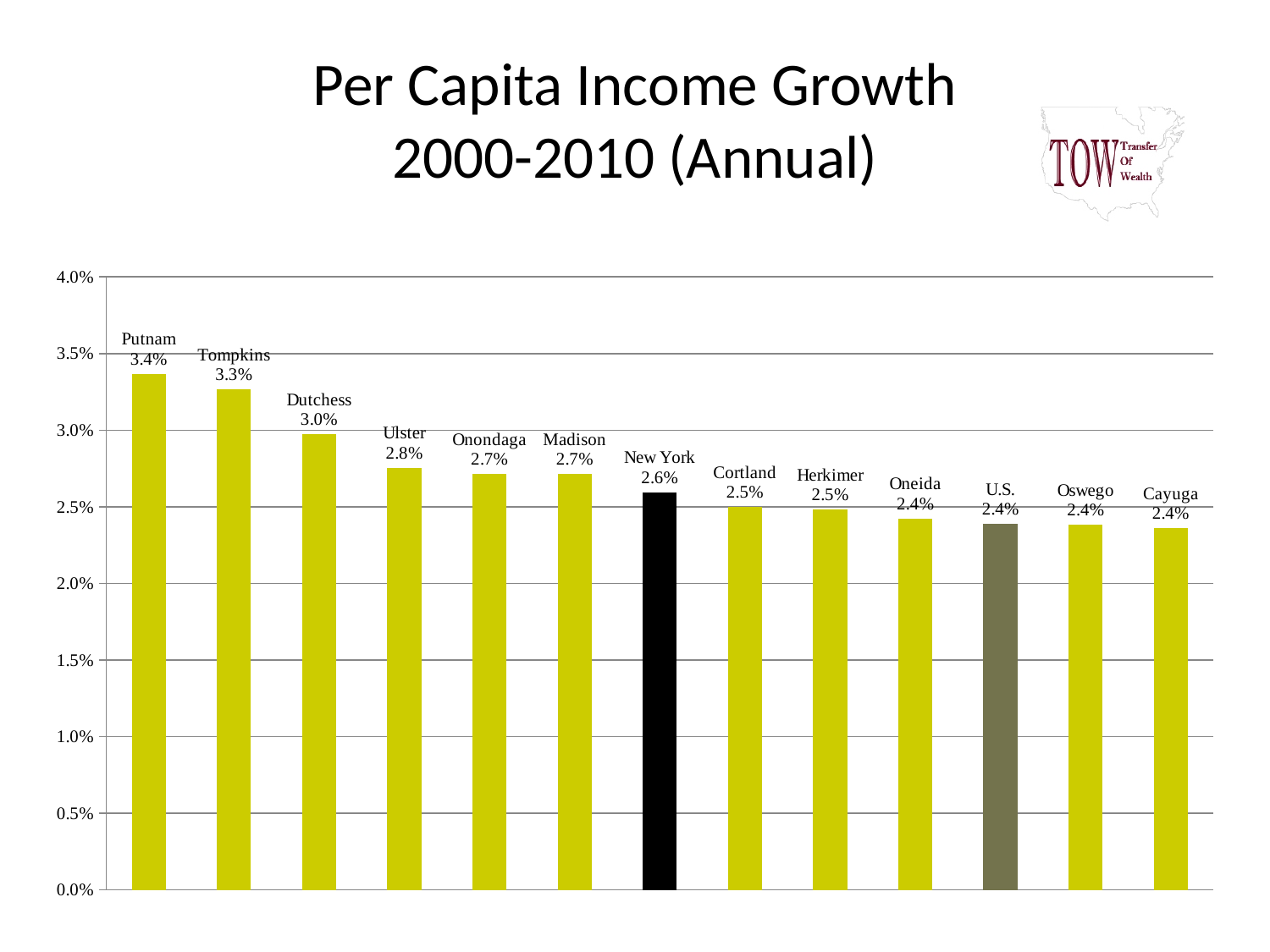
What is the per capita income growth value for the U.S.? 2.4% What is the per capita income growth value for Putnam? 3.4% Which has a larger value, Dutchess or Ulster? Dutchess What kind of chart is shown on the slide? bar chart Which category has the highest per capita income growth? Putnam Do the values rise or fall from left to right across the chart? fall What is the difference between the values for Putnam and Dutchess? 0.4 percentage points What is the per capita income growth value for New York? 2.6% How many bars are shown in the chart? 13 What is the difference between the values for Putnam and New York? 0.8 percentage points What is the per capita income growth value for Dutchess? 3.0% Is the value for Cayuga greater or less than 2.5%? less